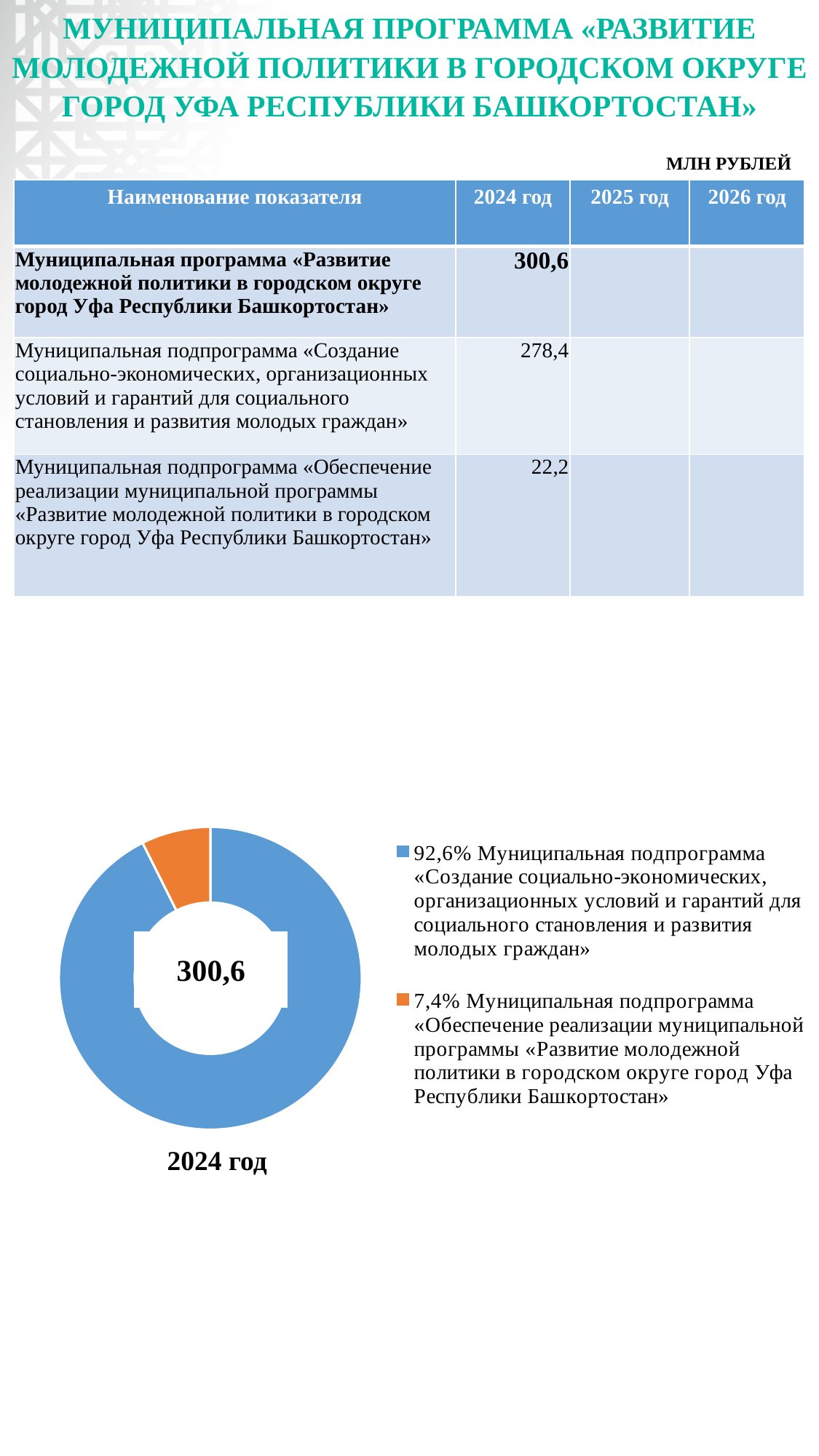
Which slice of the doughnut chart is the smallest? Муниципальная подпрограмма «Обеспечение реализации муниципальной программы «Развитие молодежной политики в городском округе город Уфа Республики Башкортостан» How many entries does the legend of the doughnut chart list? 2 What share of the doughnut chart does the subprogram «Обеспечение реализации муниципальной программы «Развитие молодежной политики в городском округе город Уфа Республики Башкортостан» take? 7,4% What year is the doughnut chart labelled with? 2024 год What kind of chart is shown on the slide? Doughnut (pie) chart Which slice of the doughnut chart is the largest? Муниципальная подпрограмма «Создание социально-экономических, организационных условий и гарантий для социального становления и развития молодых граждан» What value is printed in the centre of the doughnut chart? 300,6 What share of the doughnut chart does the subprogram «Создание социально-экономических, организационных условий и гарантий для социального становления и развития молодых граждан» take? 92,6% By how many percentage points does the 92,6% slice exceed the 7,4% slice in the doughnut chart? 85,2 Which is larger in the doughnut chart: the share of the subprogram «Создание социально-экономических...» or the share of the subprogram «Обеспечение реализации муниципальной программы...»? Муниципальная подпрограмма «Создание социально-экономических, организационных условий и гарантий для социального становления и развития молодых граждан» How many slices does the doughnut chart have? 2